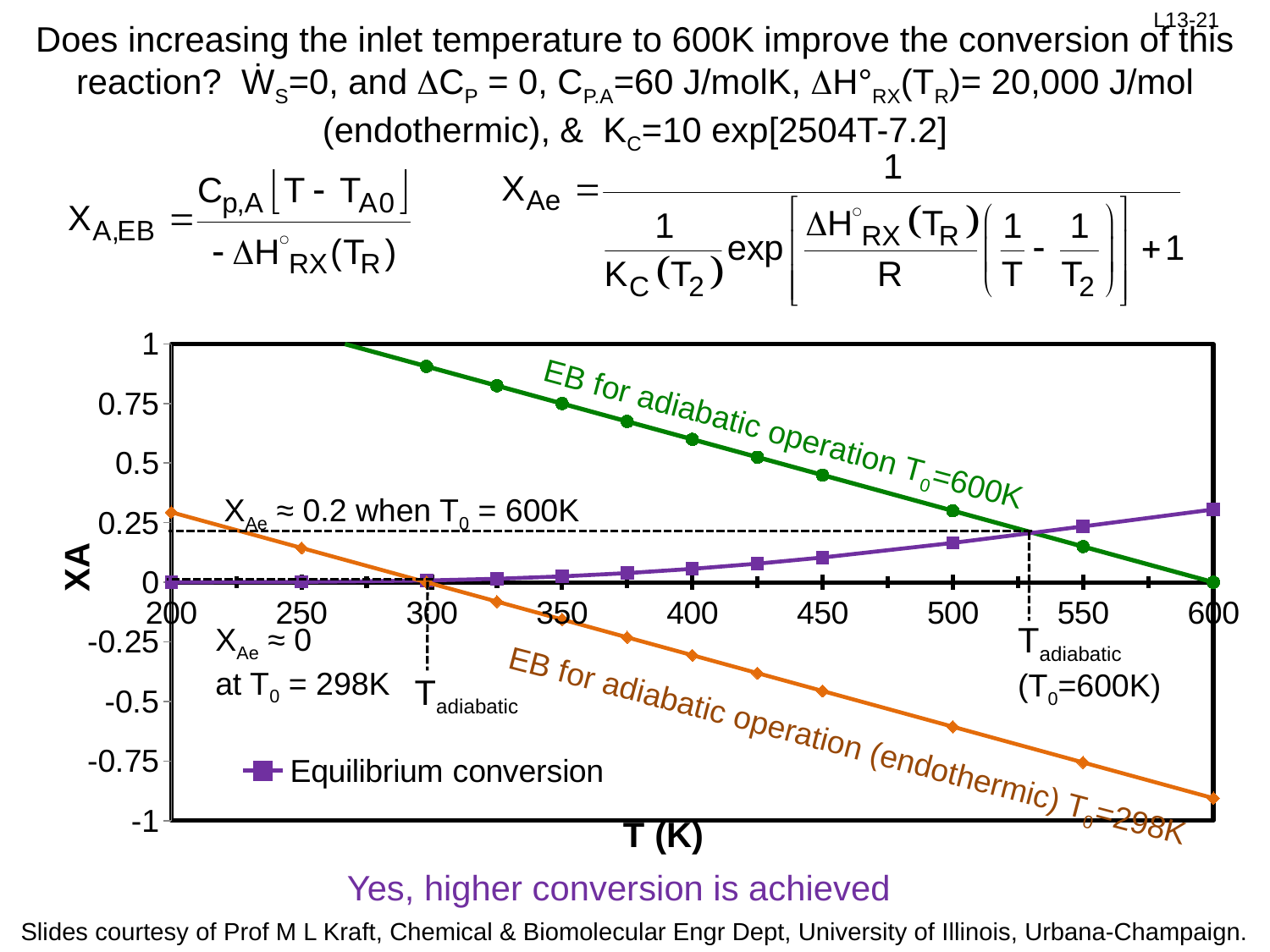
Is the value of the 'EB for adiabatic operation T0=600K' line at T = 400 K greater or less than 0.5? greater Is the Equilibrium conversion value at T = 500 K greater or less than 0.25? less What kind of chart is shown on the slide? line chart How many series does the chart's legend list? 1 At T = 400 K, which is larger: the 'EB for adiabatic operation T0=600K' line or the Equilibrium conversion line? EB for adiabatic operation T0=600K What is the only series named in the chart's legend? Equilibrium conversion What is the title of the x axis of the chart? T (K) Which of the three plotted lines has the highest value at T = 450 K? EB for adiabatic operation T0=600K Does the 'EB for adiabatic operation T0=600K' line rise or fall as T increases? fall Does the Equilibrium conversion line rise or fall as T increases from 300 K to 600 K? rise At T = 500 K, which is larger: the Equilibrium conversion line or the 'EB for adiabatic operation (endothermic) T0=298K' line? Equilibrium conversion Is the value of the 'EB for adiabatic operation (endothermic) T0=298K' line at T = 500 K greater or less than -0.5? less